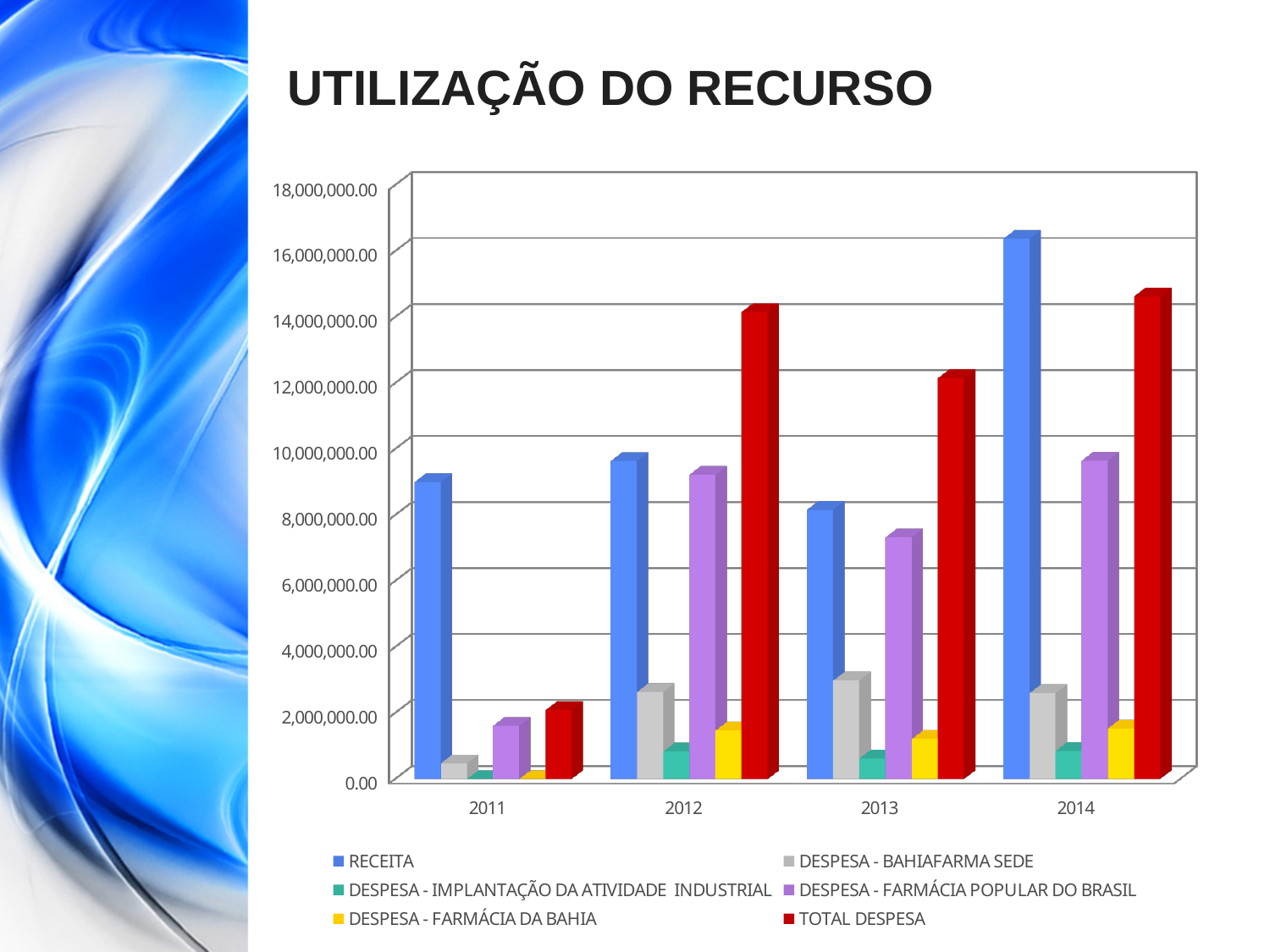
What kind of chart is shown on the slide? Bar chart In 2014, which is larger: RECEITA or TOTAL DESPESA? RECEITA Is the value of TOTAL DESPESA in 2011 greater or less than 4,000,000.00? less Is the value of DESPESA - FARMÁCIA POPULAR DO BRASIL in 2013 greater or less than 8,000,000.00? less Is the value of RECEITA in 2014 greater or less than 14,000,000.00? greater In which year is RECEITA highest? 2014 How many years are shown on the x axis of the chart? 4 How many series does the chart legend list? 6 In 2012, which is larger: RECEITA or TOTAL DESPESA? TOTAL DESPESA What is the title of the slide containing the chart? UTILIZAÇÃO DO RECURSO In which year is TOTAL DESPESA lowest? 2011